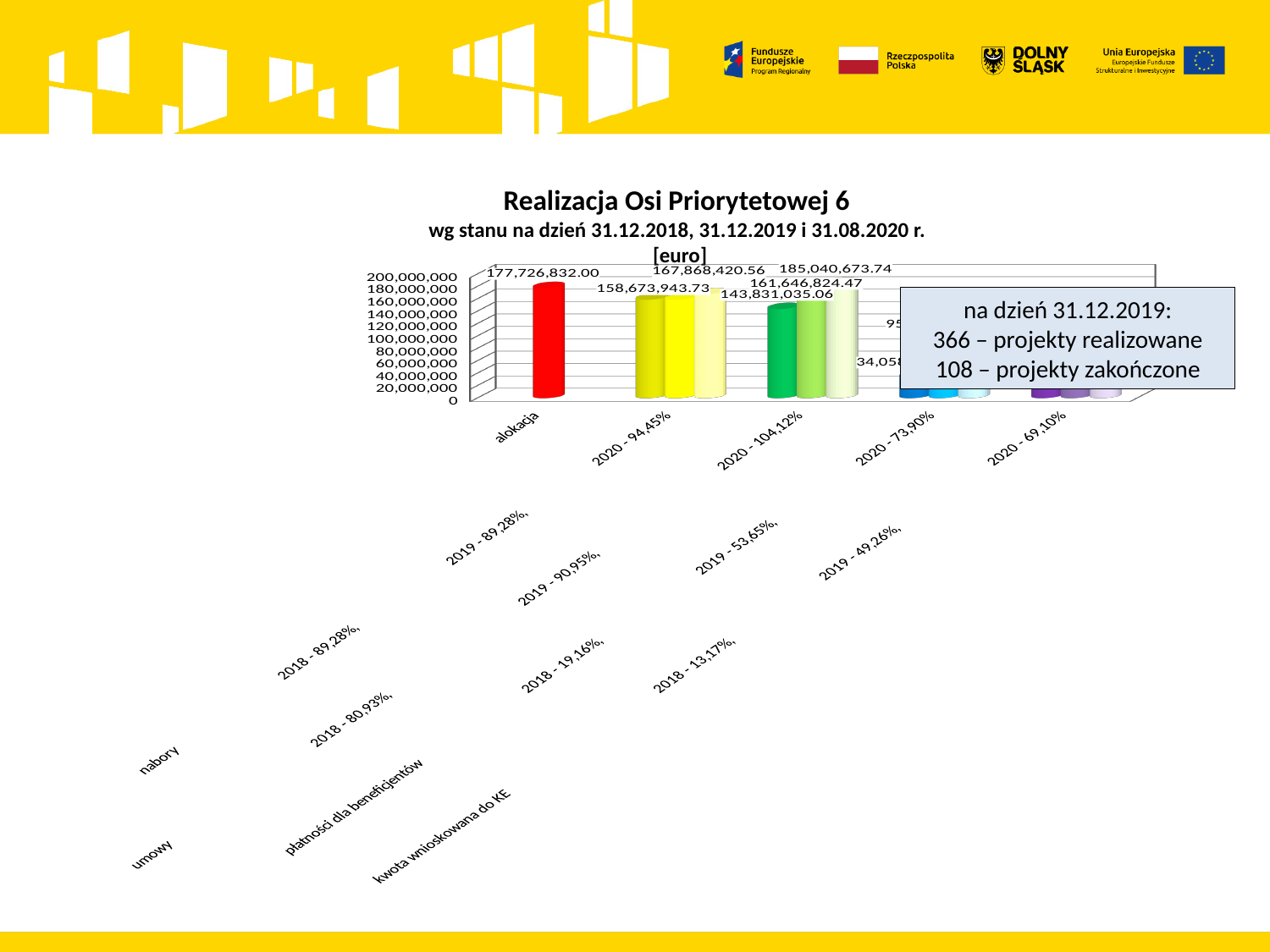
What is the highest value printed as a data label on the chart? 185,040,673.74 Is the value of the alokacja bar greater or less than 160,000,000? greater What is the title of the chart? Realizacja Osi Priorytetowej 6 Which is larger: the printed value 185,040,673.74 or the alokacja value 177,726,832.00? 185,040,673.74 In what unit are the chart values expressed, according to the chart subtitle? euro What is the value of the alokacja bar? 177,726,832.00 What percentage is given for 2020 in the x-axis label of the umowy group? 104,12% What is the highest tick value shown on the vertical axis? 200,000,000 What kind of chart is shown on the slide? bar chart How many categories are labelled along the x axis (alokacja, nabory, umowy, płatności dla beneficjentów, kwota wnioskowana do KE)? 5 What percentage is given for 2020 in the x-axis label of the nabory group? 94,45%